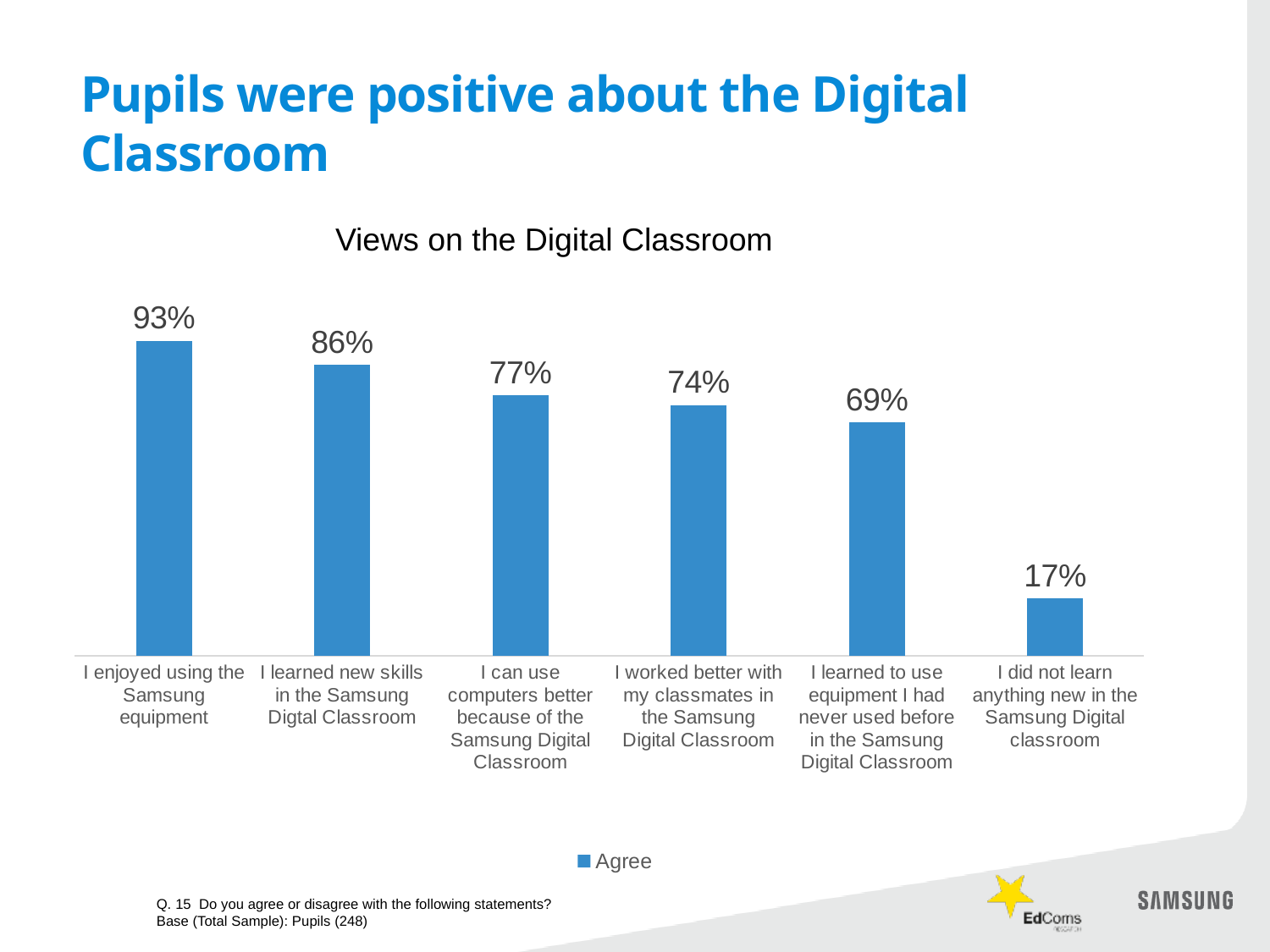
How many series does the legend list? 1 What is the difference between the agreement for "I learned new skills in the Samsung Digtal Classroom" and "I can use computers better because of the Samsung Digital Classroom"? 9% What percentage agreed with "I did not learn anything new in the Samsung Digital classroom"? 17% Which is larger: the value for "I worked better with my classmates in the Samsung Digital Classroom" or for "I learned to use equipment I had never used before in the Samsung Digital Classroom"? I worked better with my classmates in the Samsung Digital Classroom What is the name of the series shown in the legend? Agree What is the title of the chart? Views on the Digital Classroom Which statement has the highest agreement? I enjoyed using the Samsung equipment What percentage of pupils agreed with "I enjoyed using the Samsung equipment"? 93% What kind of chart is shown on the slide? Bar chart What is the value for "I learned to use equipment I had never used before in the Samsung Digital Classroom"? 69% How many statements are shown in the chart? 6 Which statement has the lowest agreement? I did not learn anything new in the Samsung Digital classroom